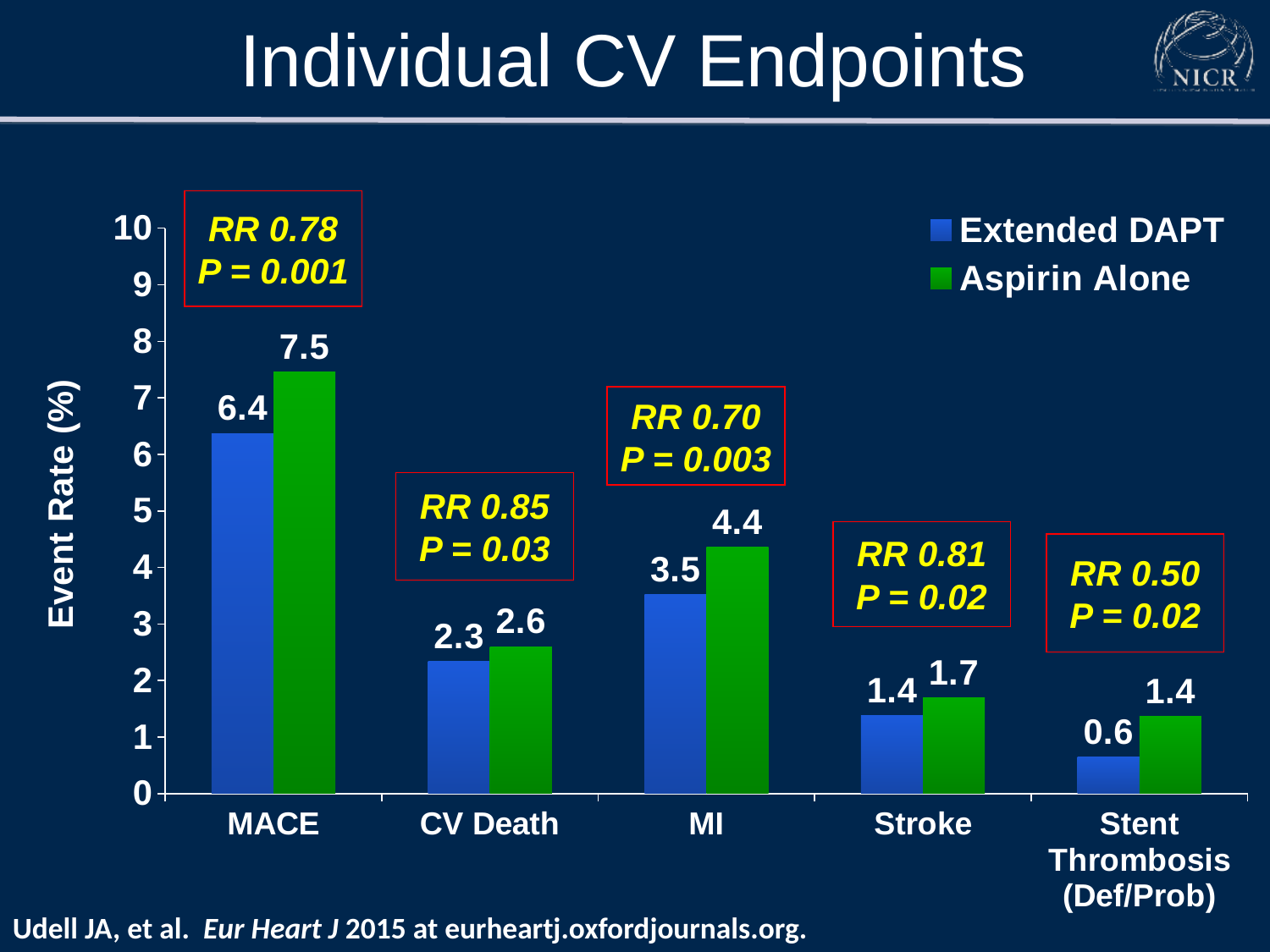
What is the label of the y axis? Event Rate (%) Which category has the highest event rate for Aspirin Alone? MACE Which is larger for CV Death: the Extended DAPT event rate or the Aspirin Alone event rate? Aspirin Alone Which category has the lowest event rate for Extended DAPT? Stent Thrombosis (Def/Prob) How many endpoint categories are shown on the x axis? 5 What is the event rate for Aspirin Alone in the MI category? 4.4 What is the difference between the Aspirin Alone and Extended DAPT event rates for MACE? 1.1 What is the event rate for Extended DAPT for Stent Thrombosis (Def/Prob)? 0.6 What kind of chart is shown on the slide? Bar chart What is the event rate for Extended DAPT in the MACE category? 6.4 How many series does the legend list? 2 What is the difference between the Aspirin Alone and Extended DAPT event rates for MI? 0.9